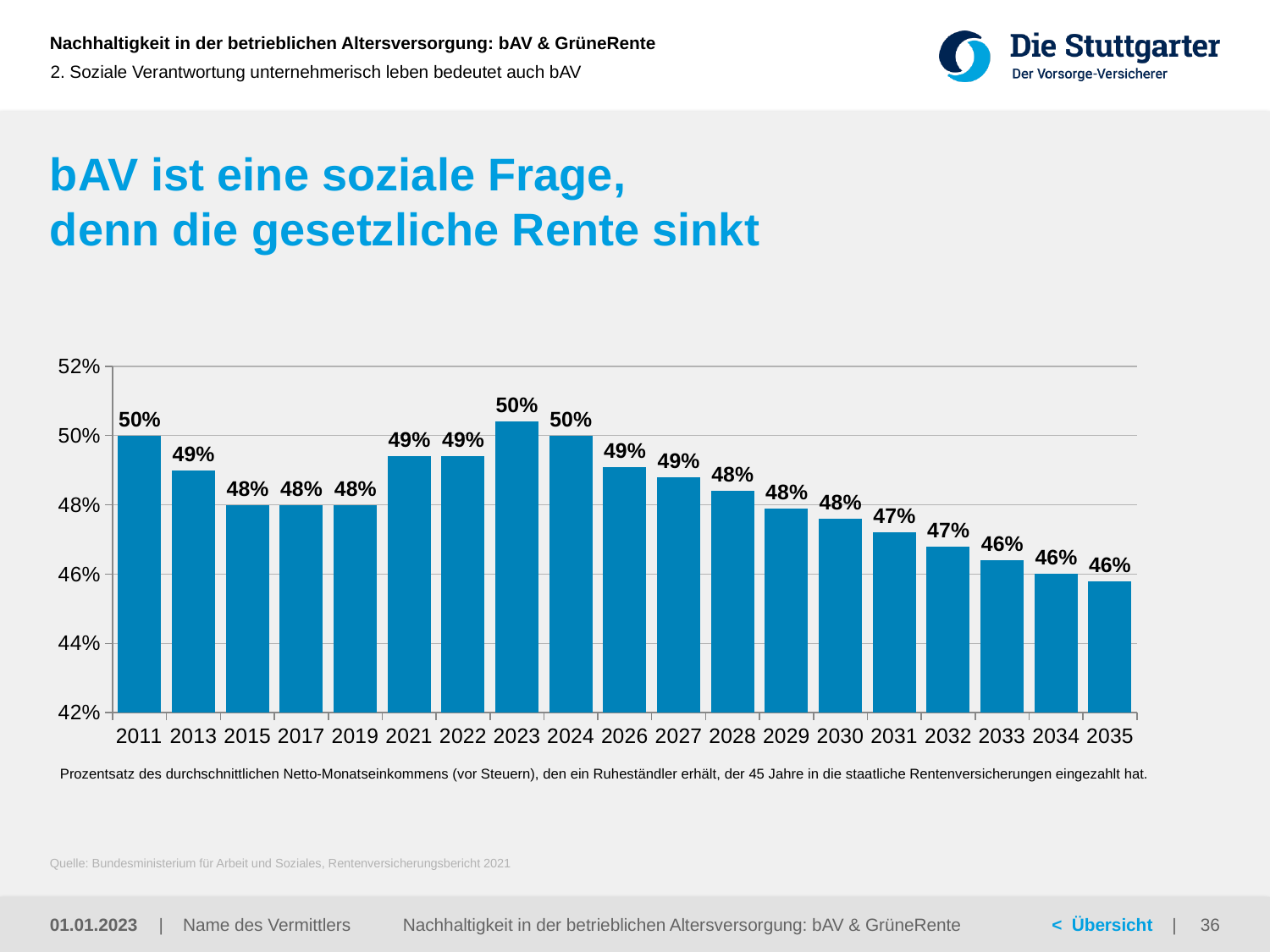
What is the value shown for 2026? 49% What is the value shown for 2035? 46% Is the value for 2031 greater or less than 46%? greater Do the values generally rise or fall from 2011 to 2035? Fall Which year has the highest bar? 2023 What is the value shown for 2031? 47% What kind of chart is shown on the slide? Bar chart Which is larger, the value for 2021 or the value for 2033? 2021 What is the value shown for 2011? 50% How many years are shown on the x axis? 19 Which year has the lowest bar? 2035 What is the difference between the values for 2011 and 2035? 4 percentage points